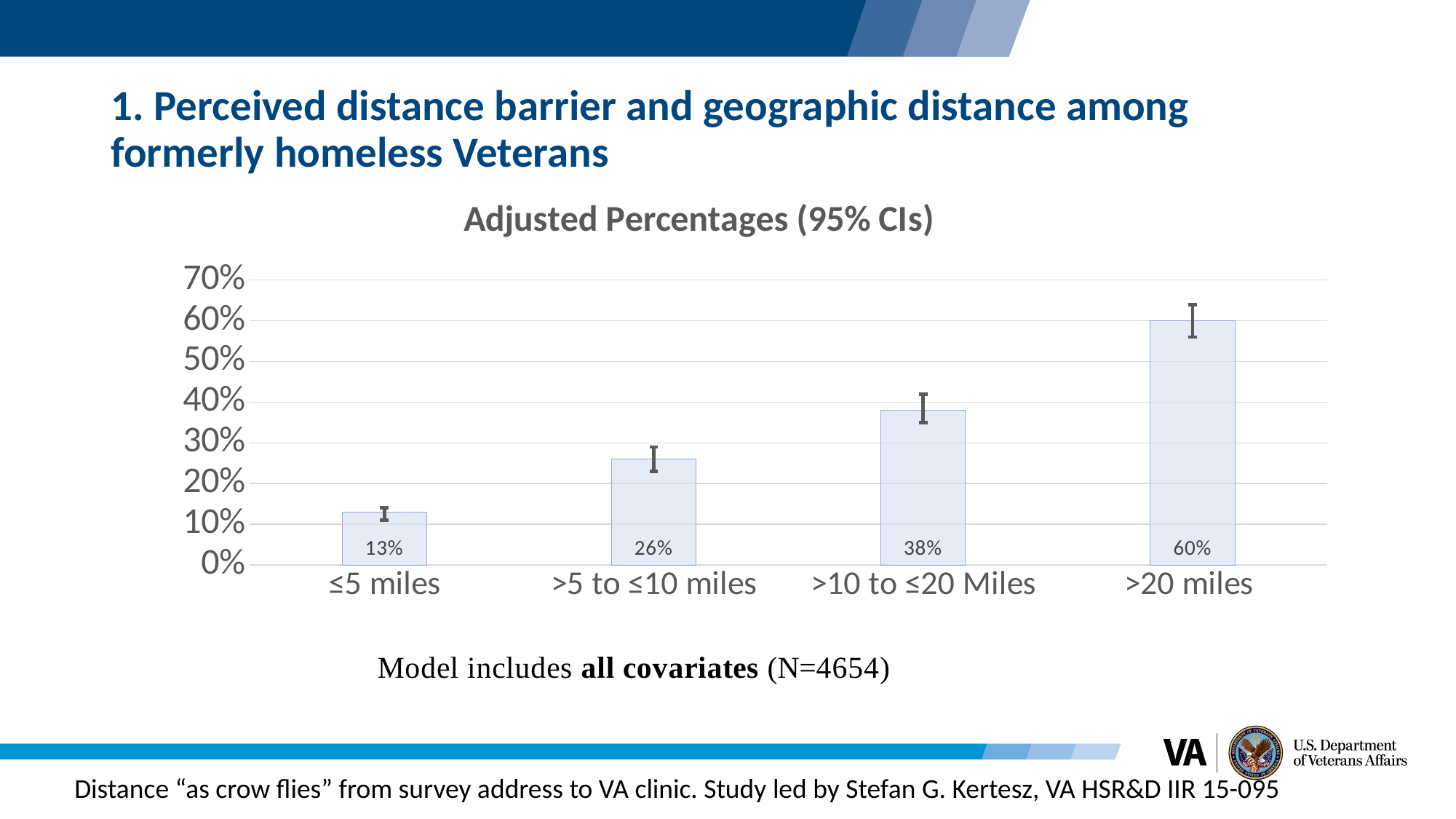
Which has a larger adjusted percentage, >5 to ≤10 miles or >10 to ≤20 Miles? >10 to ≤20 Miles What is the title of the chart? Adjusted Percentages (95% CIs) What is the adjusted percentage for the >10 to ≤20 Miles category? 38% What kind of chart is shown on the slide? Bar chart Do the adjusted percentages rise or fall as distance increases along the x axis? Rise Which distance category has the lowest adjusted percentage? ≤5 miles What is the difference in adjusted percentage between the >20 miles and ≤5 miles categories? 47% Which distance category has the highest adjusted percentage? >20 miles What is the adjusted percentage for the >5 to ≤10 miles category? 26% How many distance categories are shown in the chart? 4 What is the adjusted percentage for the ≤5 miles category? 13% What is the adjusted percentage for the >20 miles category? 60%